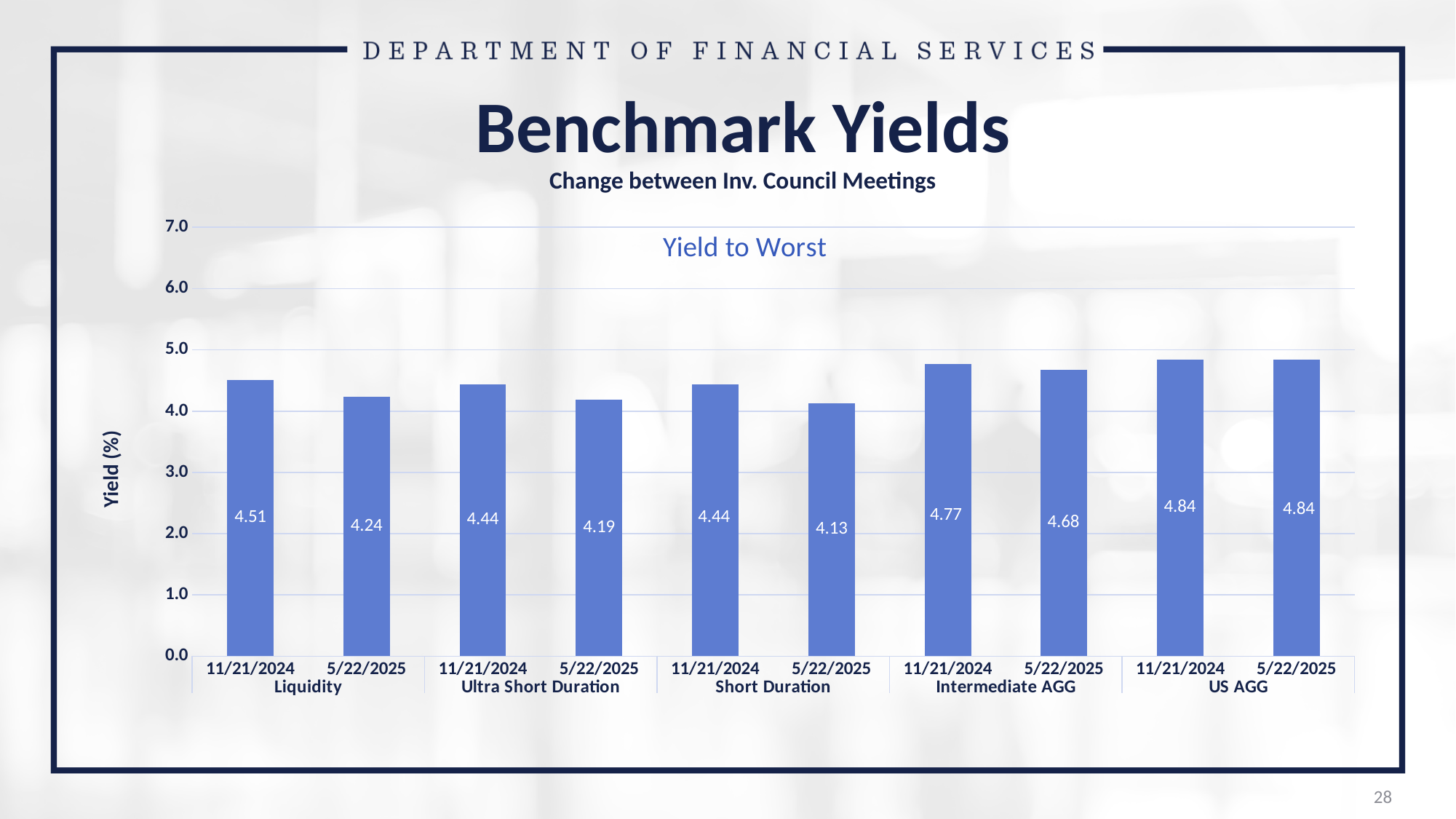
Did the Liquidity yield rise or fall from 11/21/2024 to 5/22/2025? Fall What is the Yield to Worst for Liquidity on 11/21/2024? 4.51 What type of chart is shown on the slide? Bar chart What is the difference between the Liquidity yield on 11/21/2024 and on 5/22/2025? 0.27 How many bars are plotted in the chart? 10 What is the difference between the Ultra Short Duration yield on 11/21/2024 and on 5/22/2025? 0.25 Which is larger: the Intermediate AGG yield on 11/21/2024 or the Liquidity yield on 11/21/2024? Intermediate AGG on 11/21/2024 What is the label on the vertical axis of the chart? Yield (%) What is the Yield to Worst for US AGG on 11/21/2024? 4.84 What is the Yield to Worst for Short Duration on 5/22/2025? 4.13 What is the Yield to Worst for Intermediate AGG on 5/22/2025? 4.68 Which bar has the lowest Yield to Worst value? Short Duration, 5/22/2025